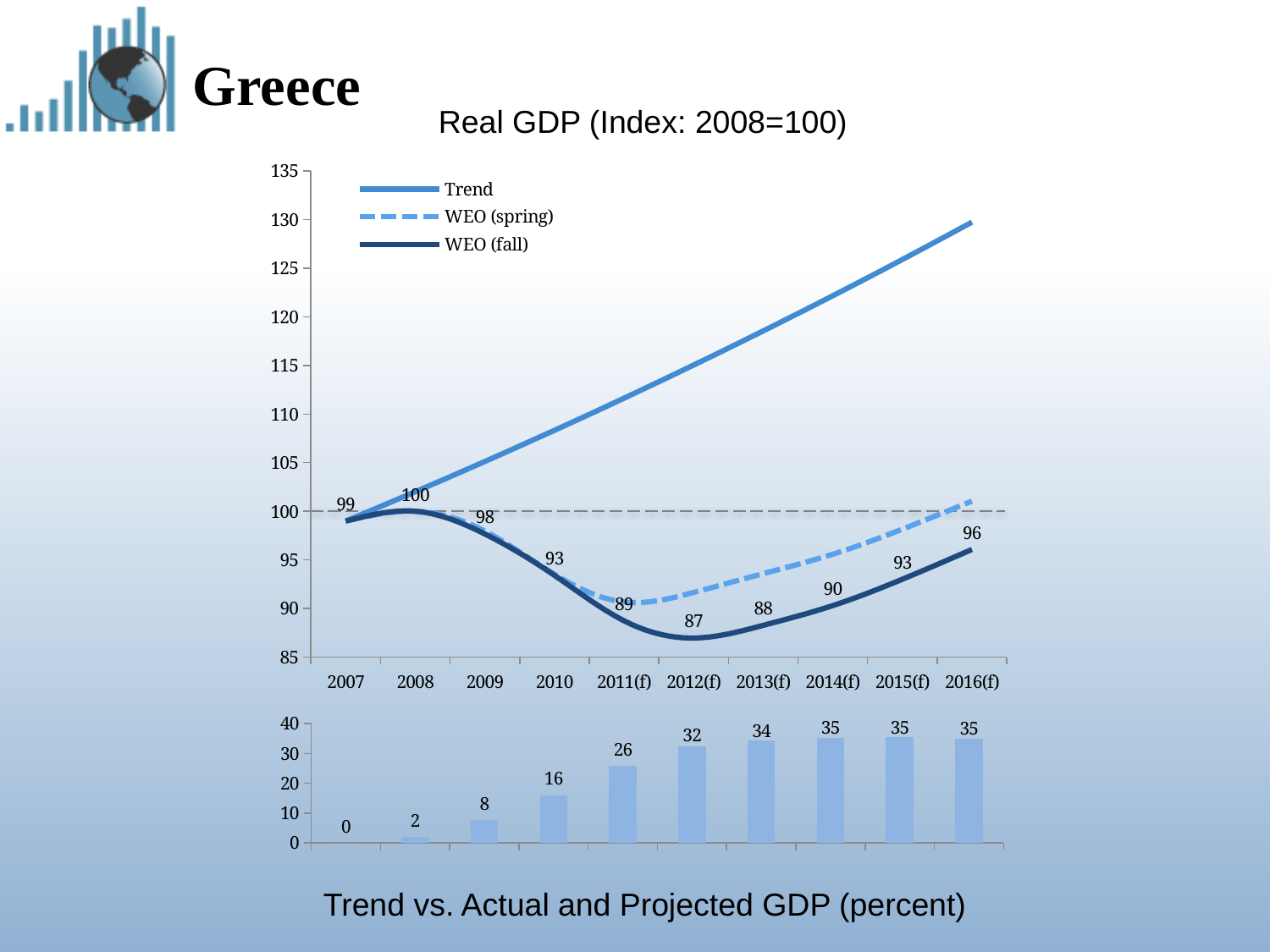
In the Real GDP (Index: 2008=100) chart, which series is drawn with a dashed line? WEO (spring) In the Real GDP (Index: 2008=100) chart, what is the WEO (fall) value for 2016(f)? 96 In the Real GDP (Index: 2008=100) chart, what is the WEO (fall) value for 2012(f)? 87 What kind of chart is the Trend vs. Actual and Projected GDP (percent) chart? bar chart In the Real GDP (Index: 2008=100) chart, is the Trend value for 2016(f) greater or less than 125? greater In the Trend vs. Actual and Projected GDP (percent) chart, how many bars are plotted? 10 In the Trend vs. Actual and Projected GDP (percent) chart, what is the value for 2011(f)? 26 In the Trend vs. Actual and Projected GDP (percent) chart, do the values rise or fall from 2007 to 2014(f)? rise In the Real GDP (Index: 2008=100) chart, in which year does the WEO (fall) line reach its lowest labelled value? 2012(f) In the Trend vs. Actual and Projected GDP (percent) chart, what is the difference between the values for 2013(f) and 2010? 18 In the Real GDP (Index: 2008=100) chart, how many series does the legend list? 3 In the Real GDP (Index: 2008=100) chart, what is the difference between the WEO (fall) values for 2008 and 2012(f)? 13